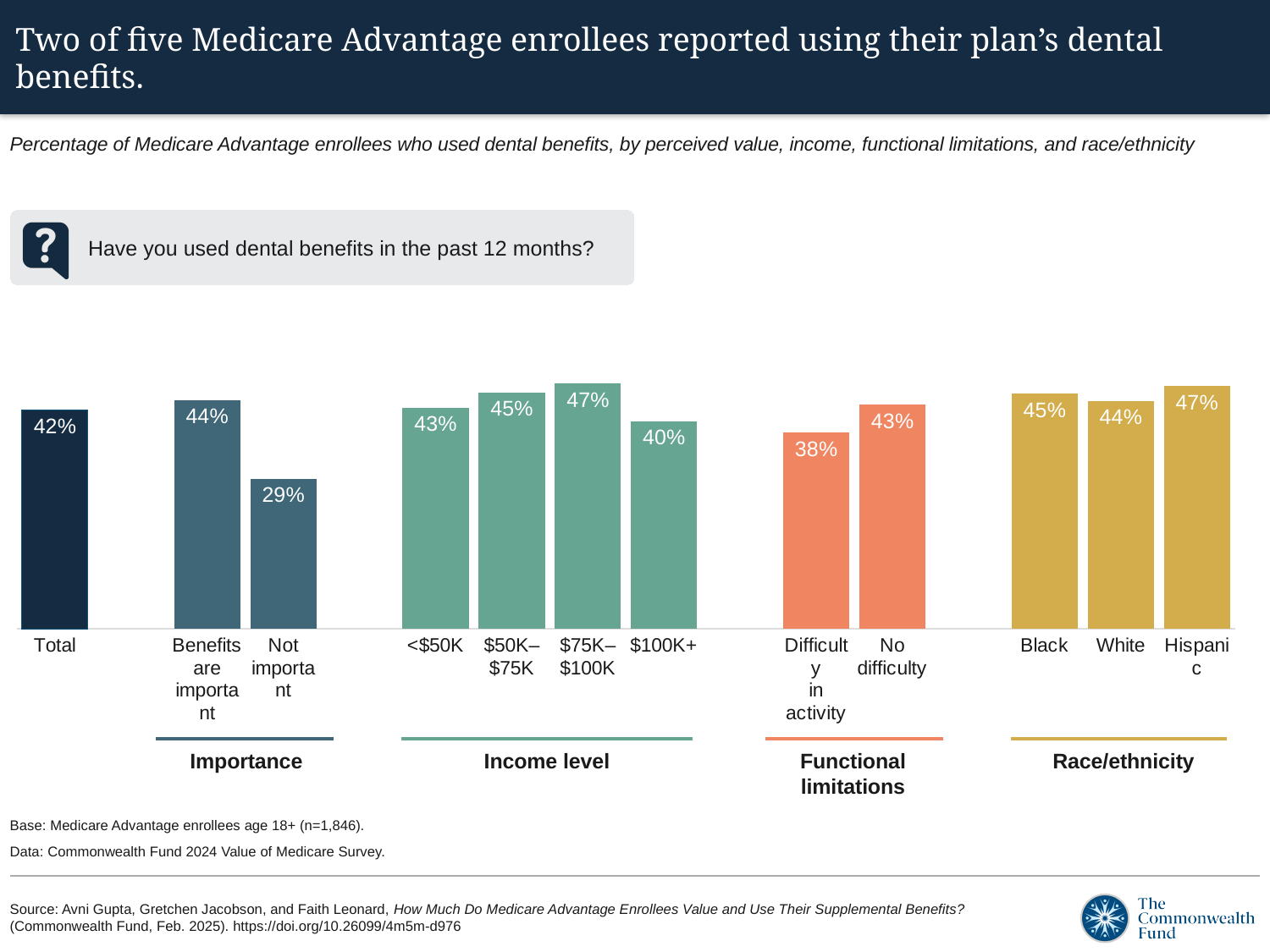
Which category has the lowest value on the chart? Not important What is the value for enrollees with difficulty in activity? 38% Within the Income level group, which category has the highest value? $75K–$100K What is the value for enrollees with income of $100K+? 40% How many bars are plotted on the chart? 12 Which is larger, the value for Hispanic enrollees or the value for White enrollees? Hispanic What is the difference between enrollees with no difficulty and those with difficulty in activity? 5 percentage points What kind of chart is shown on the slide? Bar chart What is the difference between enrollees who said benefits are important and those who said benefits are not important? 15 percentage points What survey question is shown in the box above the chart? Have you used dental benefits in the past 12 months? What is the value for enrollees who said benefits are not important? 29% What percentage of all Medicare Advantage enrollees (Total) used dental benefits? 42%